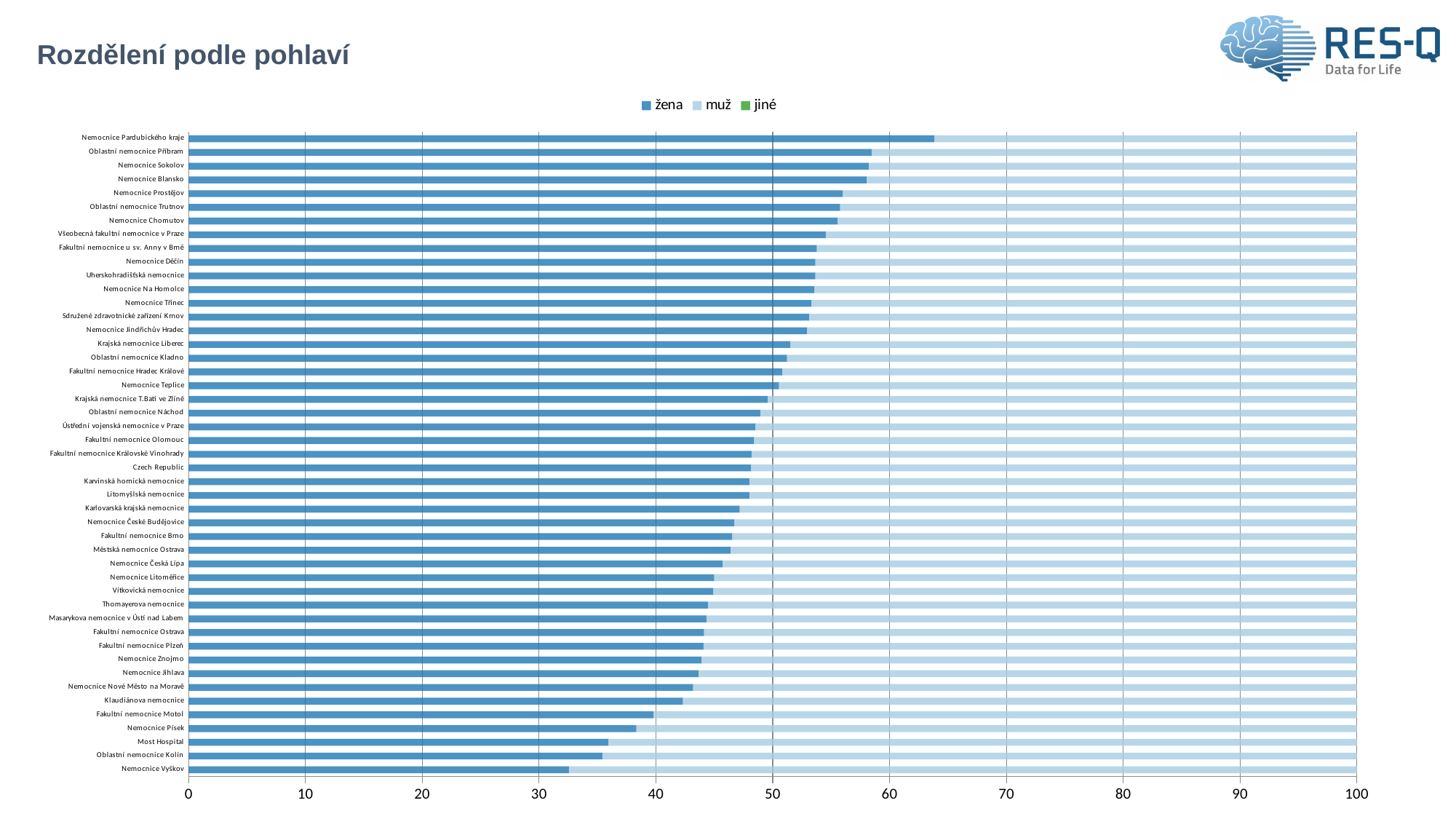
What is the title of the chart? Rozdělení podle pohlaví What are the series names listed in the legend? žena, muž, jiné Is the žena value for Nemocnice Pardubického kraje greater or less than 60? greater How many hospitals (categories) are plotted on the chart? 47 Which has a larger žena share, Oblastní nemocnice Příbram or Most Hospital? Oblastní nemocnice Příbram What kind of chart is shown on the slide? Stacked bar chart Which hospital has the lowest share for the žena series? Nemocnice Vyškov Is the žena value for Nemocnice Vyškov greater or less than 40? less Is the žena value for Nemocnice Sokolov greater or less than 50? greater How many series does the legend list? 3 Which hospital has the highest share for the žena series? Nemocnice Pardubického kraje